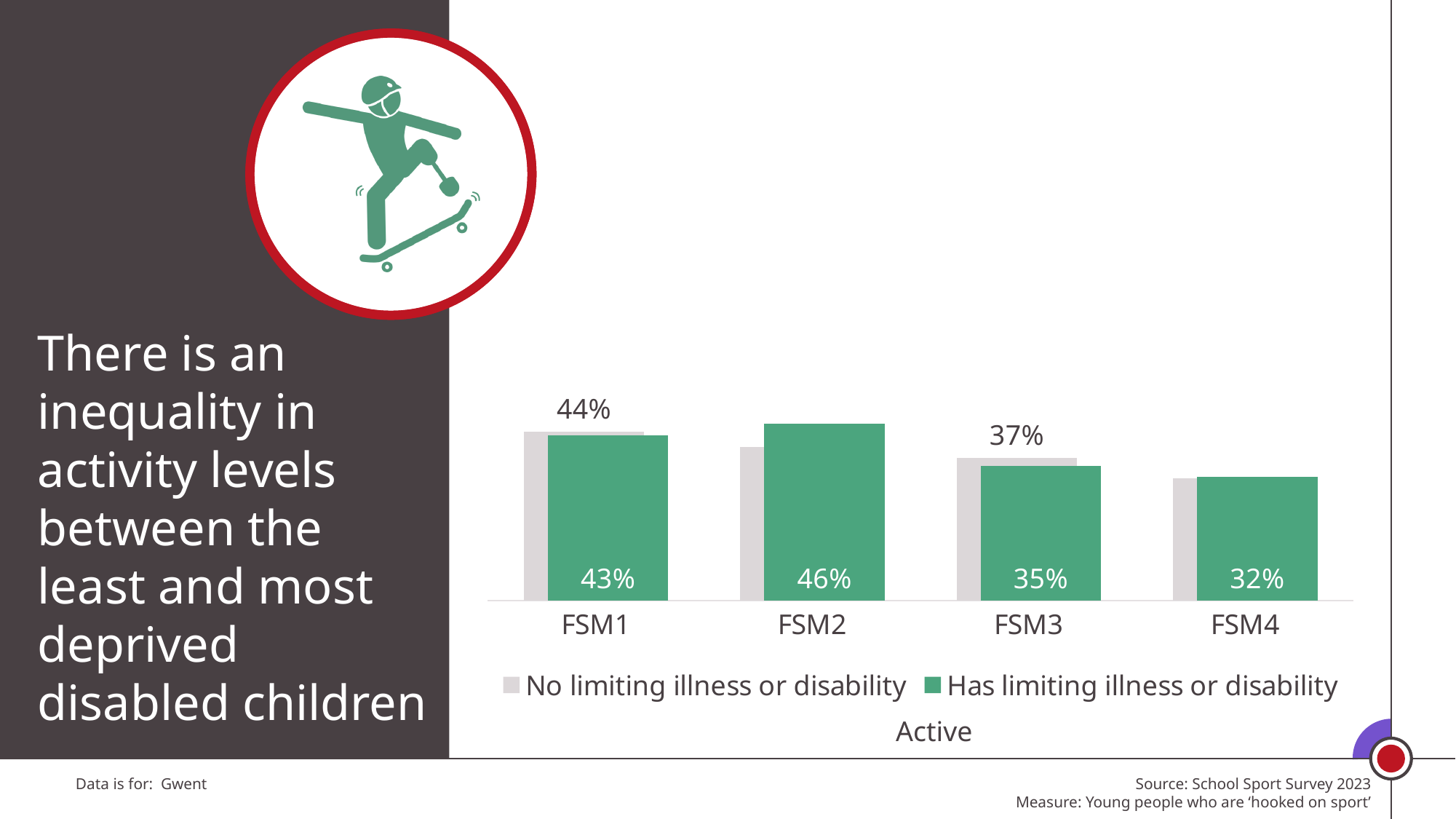
What is the value for 'No limiting illness or disability' at FSM1? 44% Which FSM category has the lowest value for 'Has limiting illness or disability'? FSM4 What is the difference between the 'No limiting illness or disability' and 'Has limiting illness or disability' values at FSM3? 2% What is the value for 'No limiting illness or disability' at FSM3? 37% What is the value for 'Has limiting illness or disability' at FSM2? 46% What kind of chart is shown on the slide? Bar chart What is the value for 'Has limiting illness or disability' at FSM4? 32% What is the difference between the 'Has limiting illness or disability' values for FSM2 and FSM4? 14% How many FSM categories are shown on the x axis? 4 How many series does the legend list? 2 At FSM1, which is larger: 'No limiting illness or disability' or 'Has limiting illness or disability'? No limiting illness or disability Which FSM category has the highest value for 'Has limiting illness or disability'? FSM2